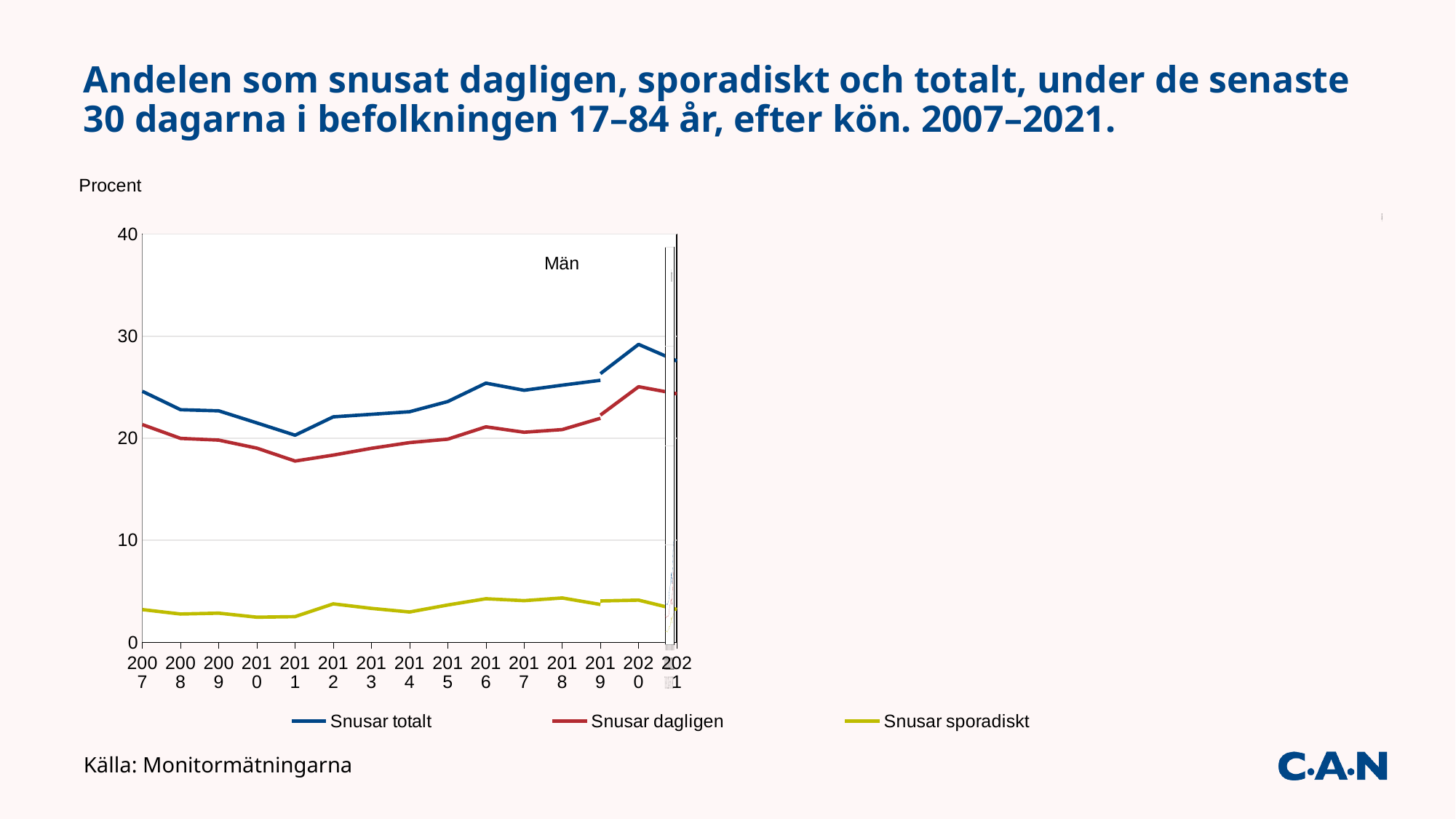
Is the value for Snusar totalt in 2007 greater or less than 20? greater Which series has the larger value in 2016, Snusar totalt or Snusar dagligen? Snusar totalt How many years are plotted along the x axis? 15 Does Snusar totalt rise or fall between 2011 and 2020? rise What kind of chart is shown on the slide? line chart In which year is Snusar dagligen at its lowest? 2011 Which group does the label inside the chart area say the chart refers to? Män How many series does the legend list? 3 In which year is Snusar totalt at its highest? 2020 Is the value for Snusar sporadiskt in 2016 greater or less than 10? less Is the value for Snusar dagligen in 2011 greater or less than 20? less